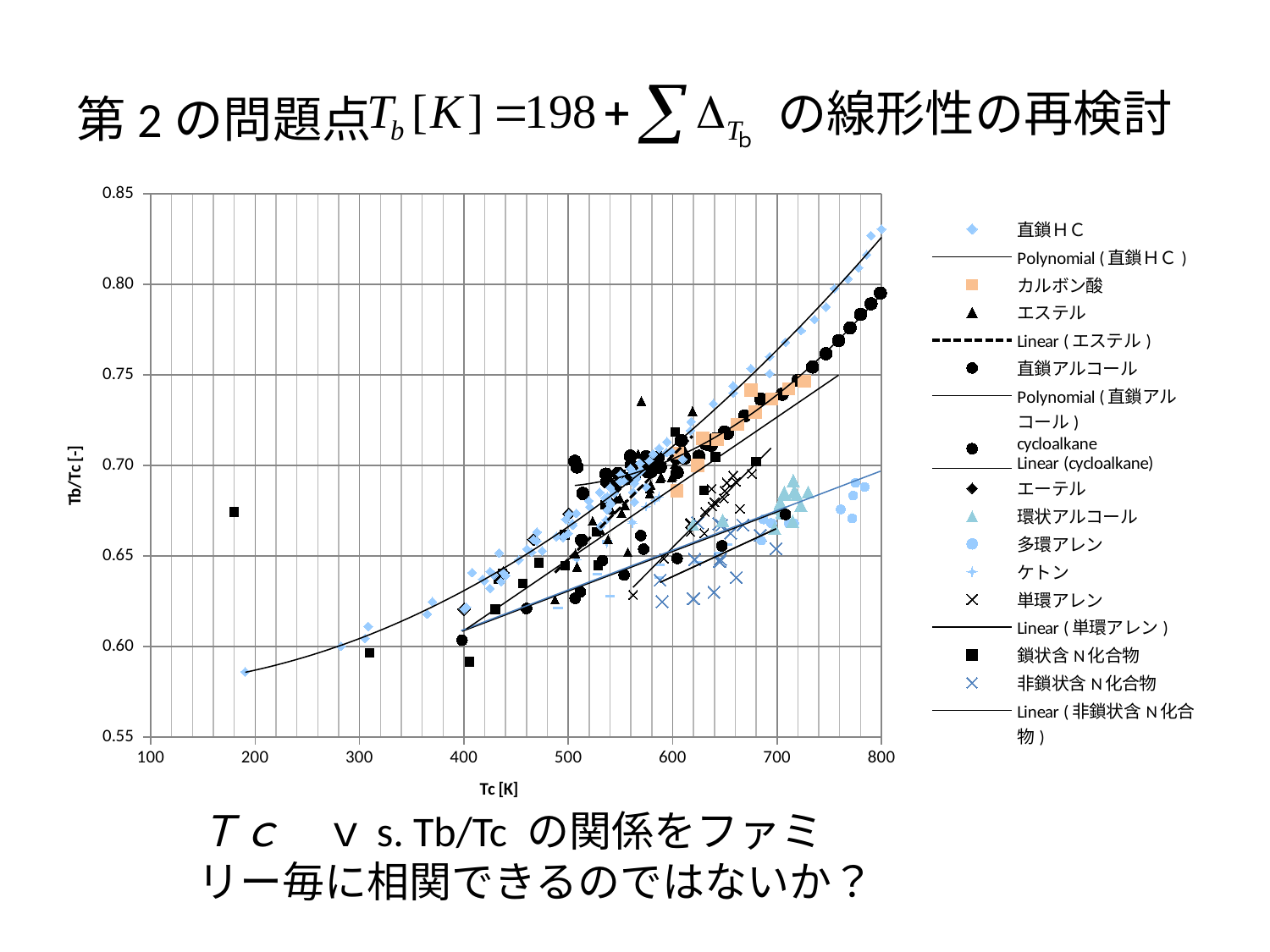
Is the Tb/Tc value of the 鎖状含N化合物 point near Tc = 180 greater or less than 0.65? greater Do the Tb/Tc values of the 直鎖アルコール series rise or fall as Tc increases? rise What is the label of the y axis of the chart? Tb/Tc [-] Is the Tb/Tc value of the leftmost 直鎖ＨＣ point (near Tc = 190) greater or less than 0.60? less What is the label of the x axis of the chart? Tc [K] Do the Tb/Tc values of the 直鎖ＨＣ series rise or fall as Tc increases? rise What is the highest value shown on the y axis? 0.85 How many entries does the chart's legend list? 18 How many marker (data point) series, excluding trendlines, does the legend list? 12 Near Tc = 800, which series has the higher Tb/Tc value, 直鎖ＨＣ or 直鎖アルコール? 直鎖ＨＣ Is the Tb/Tc value of the rightmost 直鎖ＨＣ point (near Tc = 800) greater or less than 0.80? greater What kind of chart is shown on the slide? scatter chart